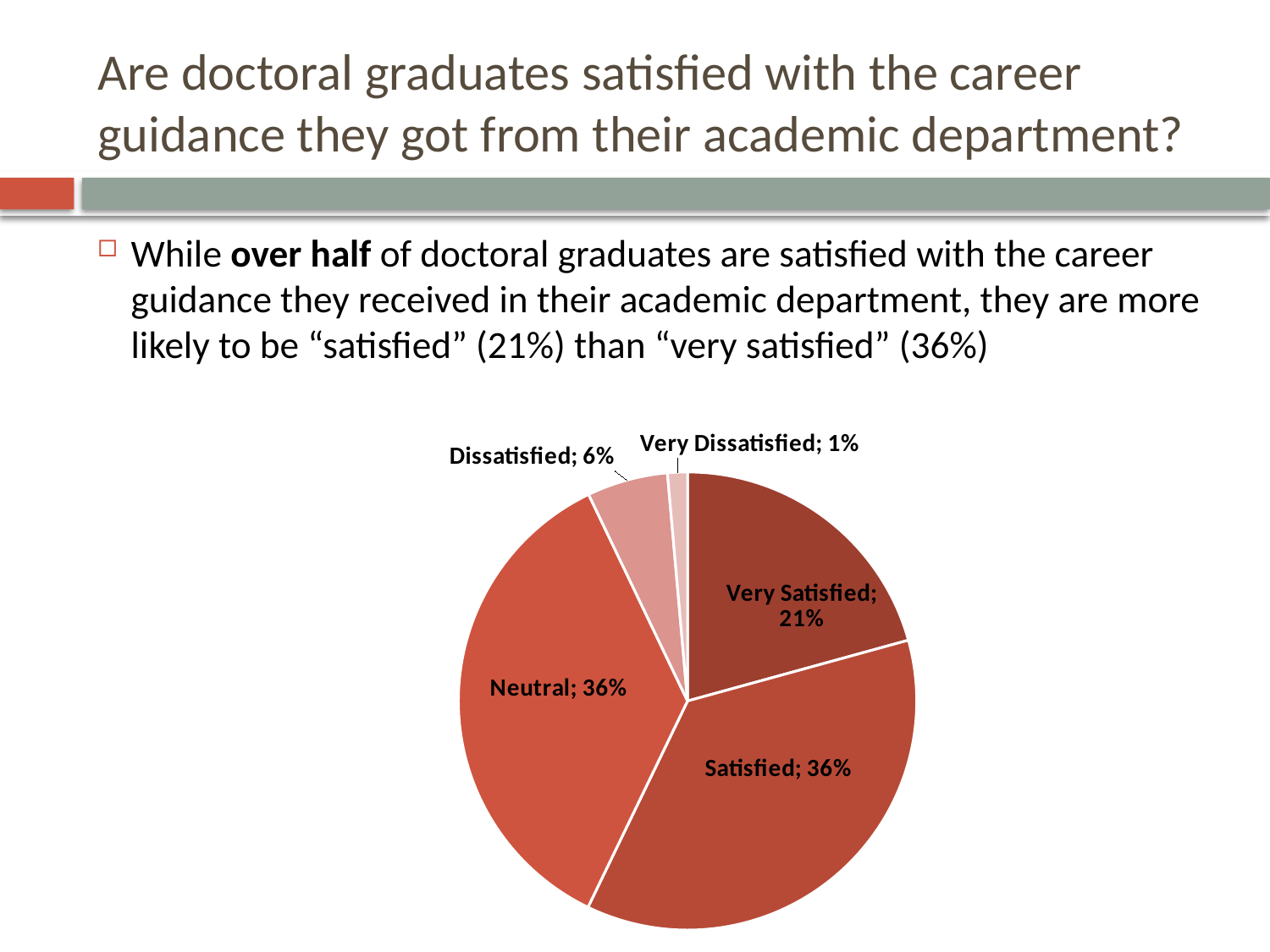
How many categories are shown in the pie chart? 5 Which slice of the pie is the darkest shade of red? Very Satisfied Which category has the smallest slice of the pie? Very Dissatisfied Which is larger, the Very Satisfied slice or the Dissatisfied slice? Very Satisfied Which two categories share the same percentage of 36%? Satisfied and Neutral What kind of chart is shown on the slide? Pie chart What is the difference in percentage points between the Very Satisfied slice (21%) and the Dissatisfied slice (6%)? 15 percentage points What is the value shown for the Very Dissatisfied slice? 1% What is the value shown for the Dissatisfied slice? 6% What share of the pie does the Neutral slice represent? 36% What is the combined percentage of the Satisfied and Very Satisfied slices? 57% What percentage of doctoral graduates are Very Satisfied with the career guidance from their academic department? 21%